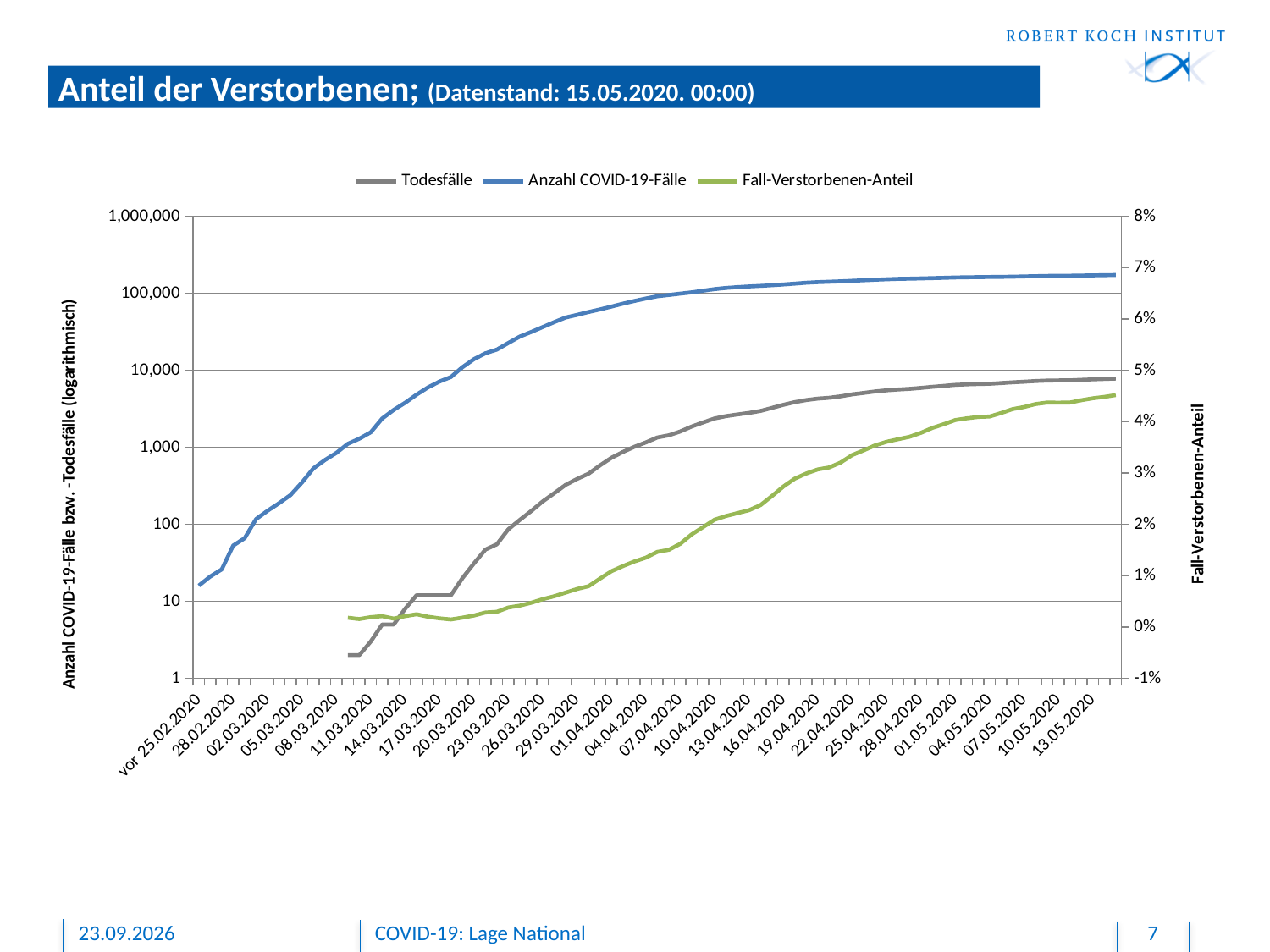
What is the label of the right-hand vertical axis? Fall-Verstorbenen-Anteil Which series is drawn in green? Fall-Verstorbenen-Anteil Does the Anzahl COVID-19-Fälle line rise or fall from left to right along the x axis? rise Does the Todesfälle line rise or fall overall from 11.03.2020 to 13.05.2020? rise Is the Fall-Verstorbenen-Anteil on 13.05.2020 greater or less than 4%? greater Is the Fall-Verstorbenen-Anteil on 07.04.2020 greater or less than 2%? less What kind of chart is shown on the slide? line chart Is the value of Anzahl COVID-19-Fälle on 13.05.2020 greater or less than 100,000? greater On 13.05.2020, which is higher on the left axis: Todesfälle or Anzahl COVID-19-Fälle? Anzahl COVID-19-Fälle How many series does the legend list? 3